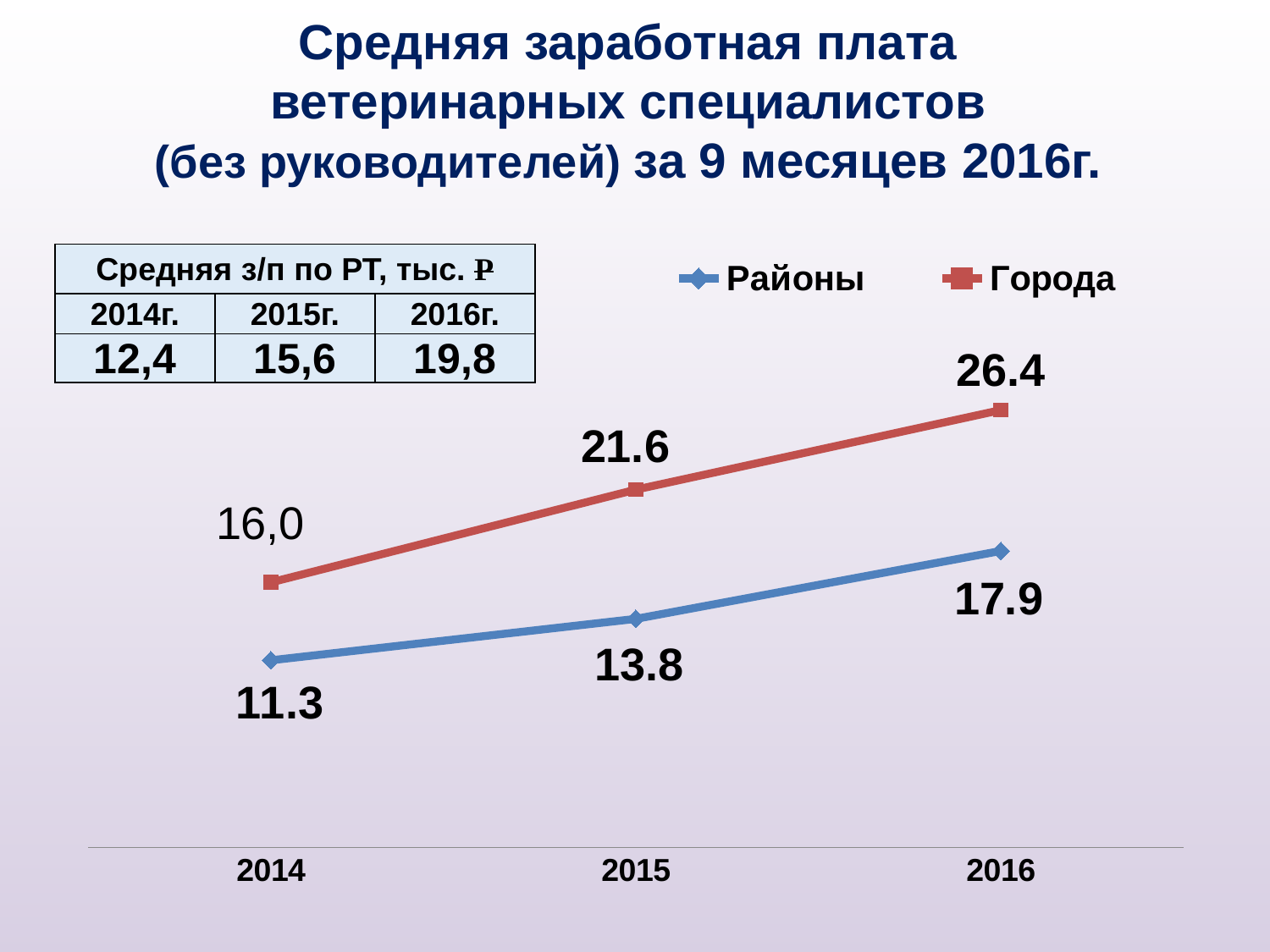
What is the value for Районы in 2015? 13.8 Do the values for Районы rise or fall from 2014 to 2016? rise In which year is the value for Города lowest? 2014 What is the difference between the Города and Районы values in 2016? 8.5 What is the value for Районы in 2014? 11.3 What are the names of the two series in the chart legend? Районы and Города What type of chart is shown on the slide? line chart How many years are shown on the x axis of the chart? 3 In which year is the value for Районы highest? 2016 What is the value for Города in 2016? 26.4 How many series does the chart legend list? 2 What is the value for Города in 2015? 21.6